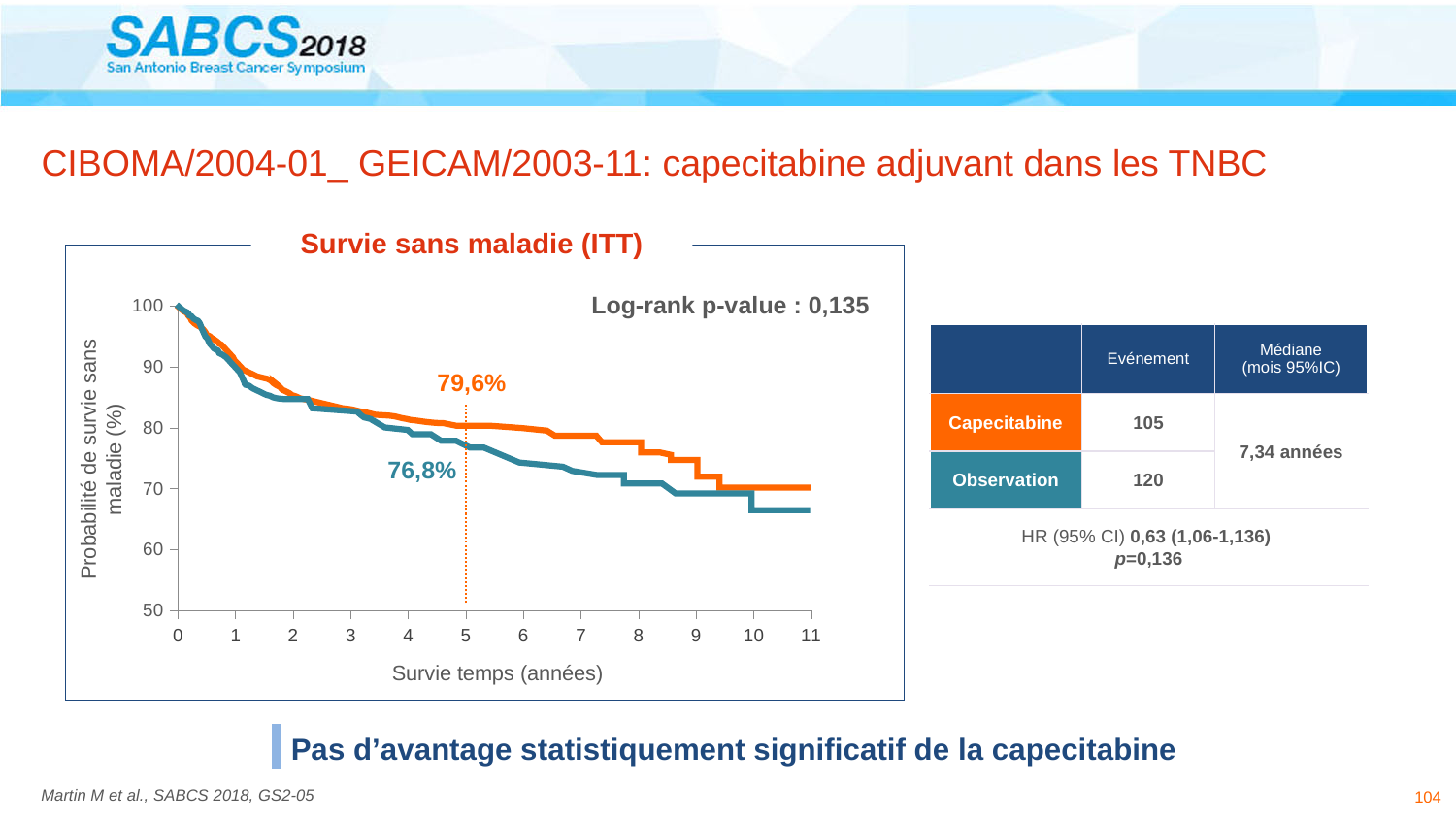
What log-rank p-value is printed on the chart? 0,135 At 5 years, which curve has the higher labelled survival probability, capecitabine or observation? Capecitabine Do the survival curves rise or fall as time increases along the x axis? Fall Is the value of the observation (teal) curve at 10 years greater or less than 70? less Is the value of the capecitabine (orange) curve at 8 years greater or less than 70? greater What is the disease-free survival probability labelled for the observation (teal) curve at 5 years? 76,8% How many curves (series) are plotted on the chart? 2 What is the title of the chart? Survie sans maladie (ITT) What is the disease-free survival probability labelled for the capecitabine (orange) curve at 5 years? 79,6% What is the label of the x axis of the chart? Survie temps (années) What kind of chart is shown on the slide? Line chart What is the difference between the labelled 5-year values of the capecitabine and observation curves? 2,8%